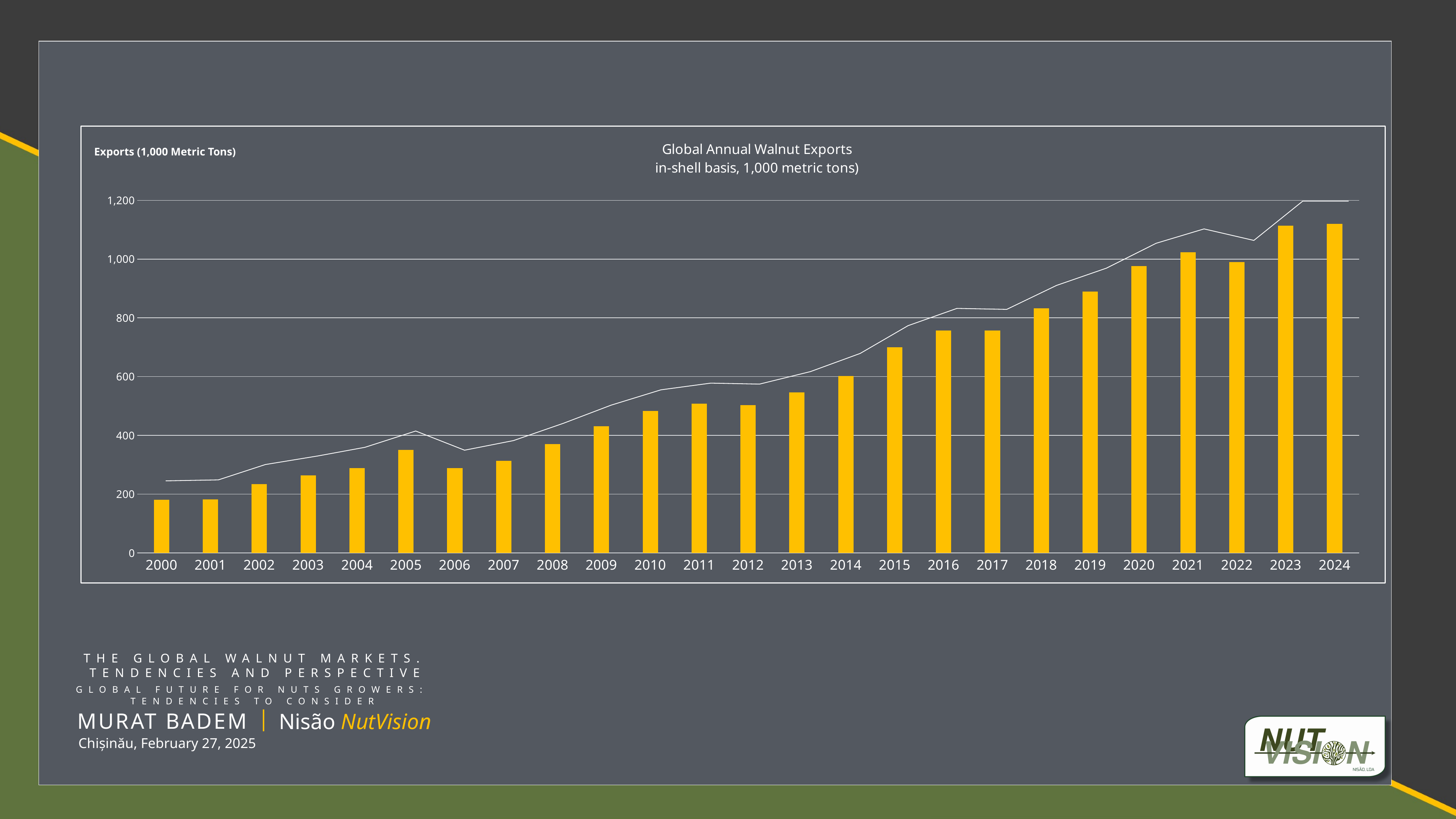
Is the value for 2024 greater or less than 1,000? greater Is the value for 2020 greater or less than 1,000? less What is the label on the vertical axis of the chart? Exports (1,000 Metric Tons) How many years are shown on the x axis of the chart? 25 Which year has the larger value, 2018 or 2019? 2019 Is the value for 2000 greater or less than 200? less What kind of chart is shown on the slide? bar chart Which year has the larger value, 2005 or 2006? 2005 What is the title of the chart? Global Annual Walnut Exports in-shell basis, 1,000 metric tons) Do the export values generally rise or fall from 2000 to 2024? rise